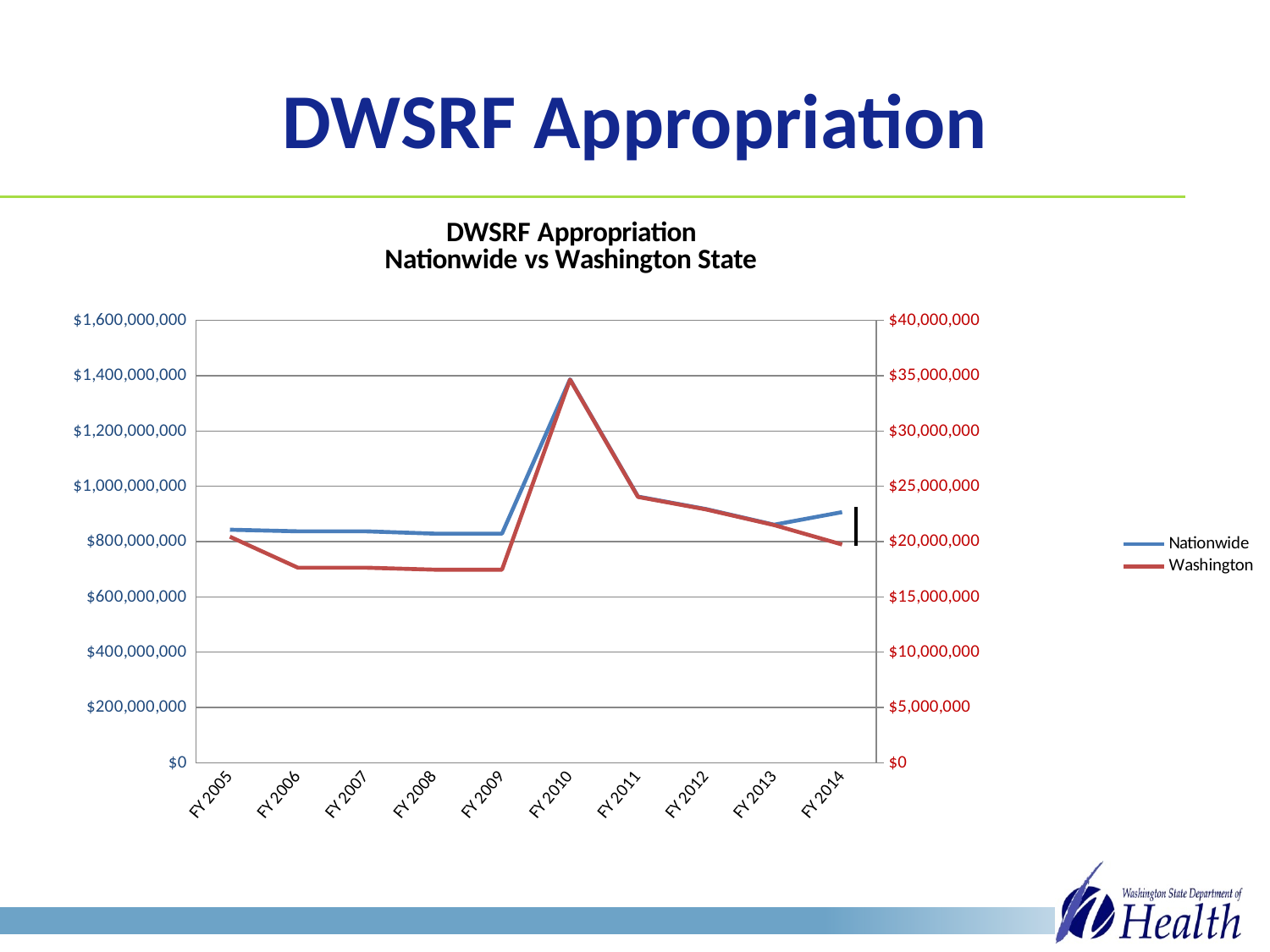
Does the Washington series rise or fall from FY 2010 to FY 2014? fall Which colour is used for the Washington series? red Is the Washington value for FY 2007 greater or less than $20,000,000? less In which fiscal year does the Nationwide series reach its highest value? FY 2010 In which fiscal year does the Washington series reach its highest value? FY 2010 Is the Nationwide value for FY 2010 greater or less than $1,200,000,000? greater How many series does the legend list? 2 How many fiscal years are plotted along the x axis? 10 Is the Washington value for FY 2010 greater or less than $30,000,000? greater What kind of chart is shown on the slide? line chart What is the title of the chart? DWSRF Appropriation Nationwide vs Washington State